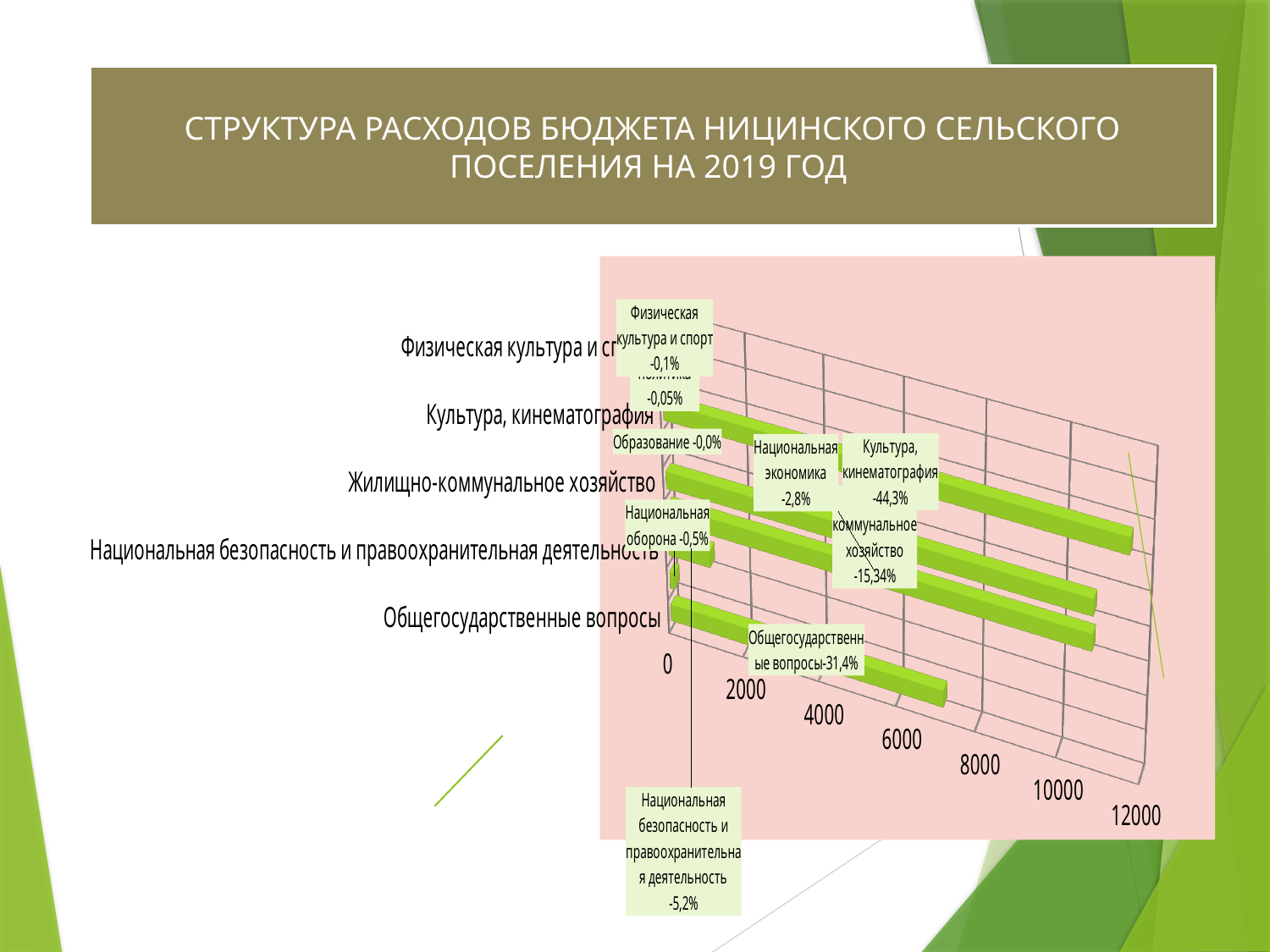
Which category has the longest bar in the chart? Культура, кинематография What percentage is shown in the label for Культура, кинематография? 44,3% What is the highest tick value shown on the value axis of the chart? 12000 What kind of chart is shown on the slide? bar chart What percentage is shown in the label for Национальная экономика? 2,8% By how many percentage points does the labelled share of Культура, кинематография exceed that of Общегосударственные вопросы? 12,9% What percentage is shown in the label for Жилищно-коммунальное хозяйство? 15,34% What percentage is shown in the label for Национальная безопасность и правоохранительная деятельность? 5,2% What percentage is shown in the label for Национальная оборона? 0,5% According to the labels, which share is larger: Общегосударственные вопросы or Жилищно-коммунальное хозяйство? Общегосударственные вопросы What percentage is shown in the label for Общегосударственные вопросы? 31,4% What percentage is shown in the label for Физическая культура и спорт? 0,1%